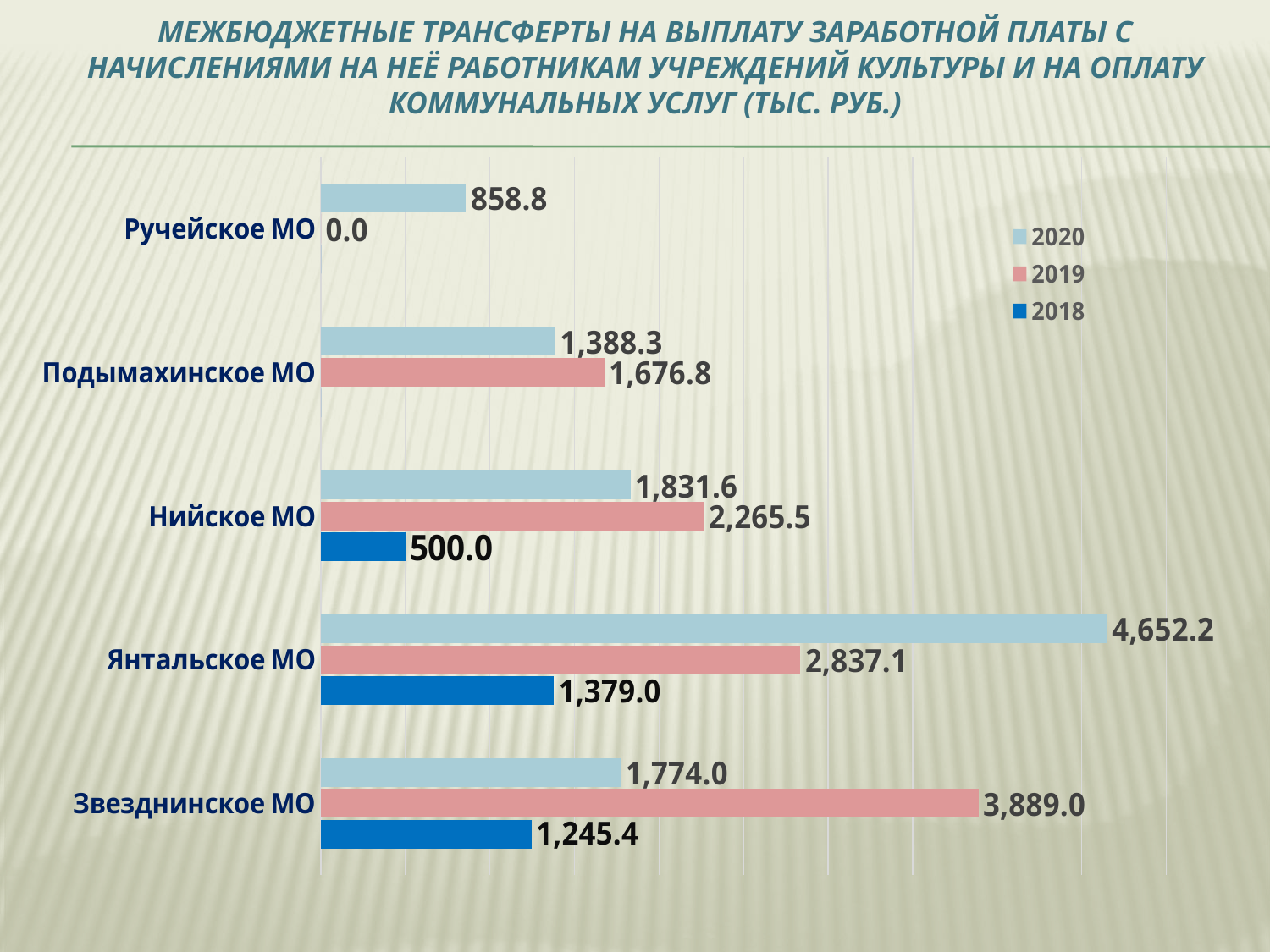
Which municipality has the lowest 2018 value among those with a 2018 bar? Нийское МО What is the difference between the 2019 and 2020 values for Звезднинское МО? 2,115.0 How many series does the legend list? 3 What is the 2020 value for Янтальское МО? 4,652.2 What is the 2018 value for Нийское МО? 500.0 What is the 2019 value for Звезднинское МО? 3,889.0 What kind of chart is shown on the slide? Bar chart Which municipality has the highest 2020 value? Янтальское МО Which year is shown in dark blue in the legend? 2018 Which is larger for Подымахинское МО: the 2019 value or the 2020 value? 2019 What is the 2020 value for Ручейское МО? 858.8 How many municipalities are shown on the chart? 5